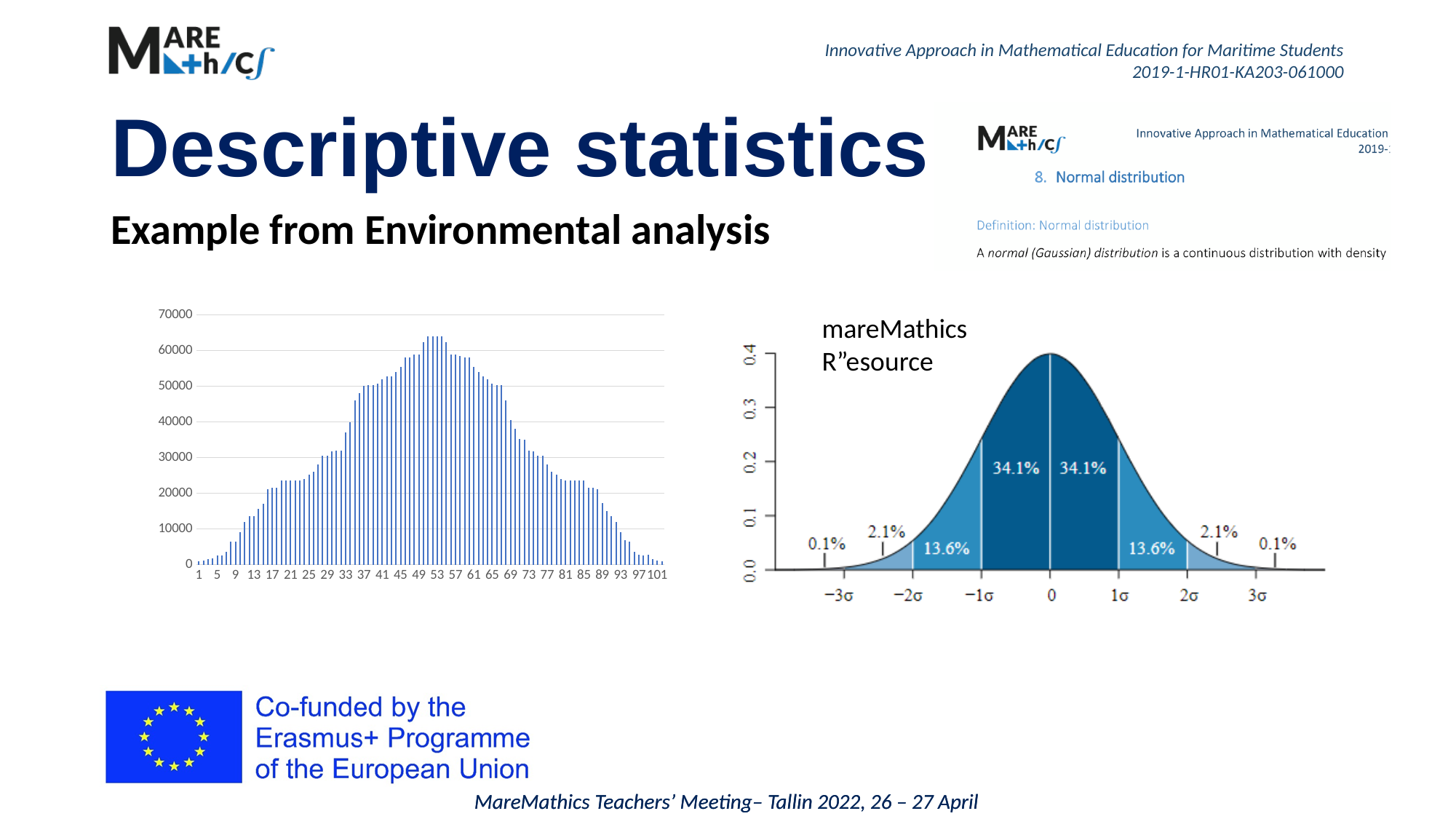
In the left bar chart, which is larger: the value for category 53 or the value for category 1? category 53 In the normal distribution diagram on the right, what percentage is labelled for the region between 1σ and 2σ? 13.6% In the left bar chart, do the values rise or fall from category 53 to category 101? fall In the left bar chart, is the value for category 25 greater or less than 20000? greater In the left bar chart, is the value for category 101 greater or less than 10000? less In the normal distribution diagram on the right, what percentage is labelled for the region between 0 and 1σ? 34.1% In the left bar chart, is the value for category 1 greater or less than 10000? less In the left bar chart, what is the highest value shown on the vertical axis? 70000 In the left bar chart, do the values rise or fall from category 1 to category 53? rise What kind of chart is shown on the left of the slide? bar chart